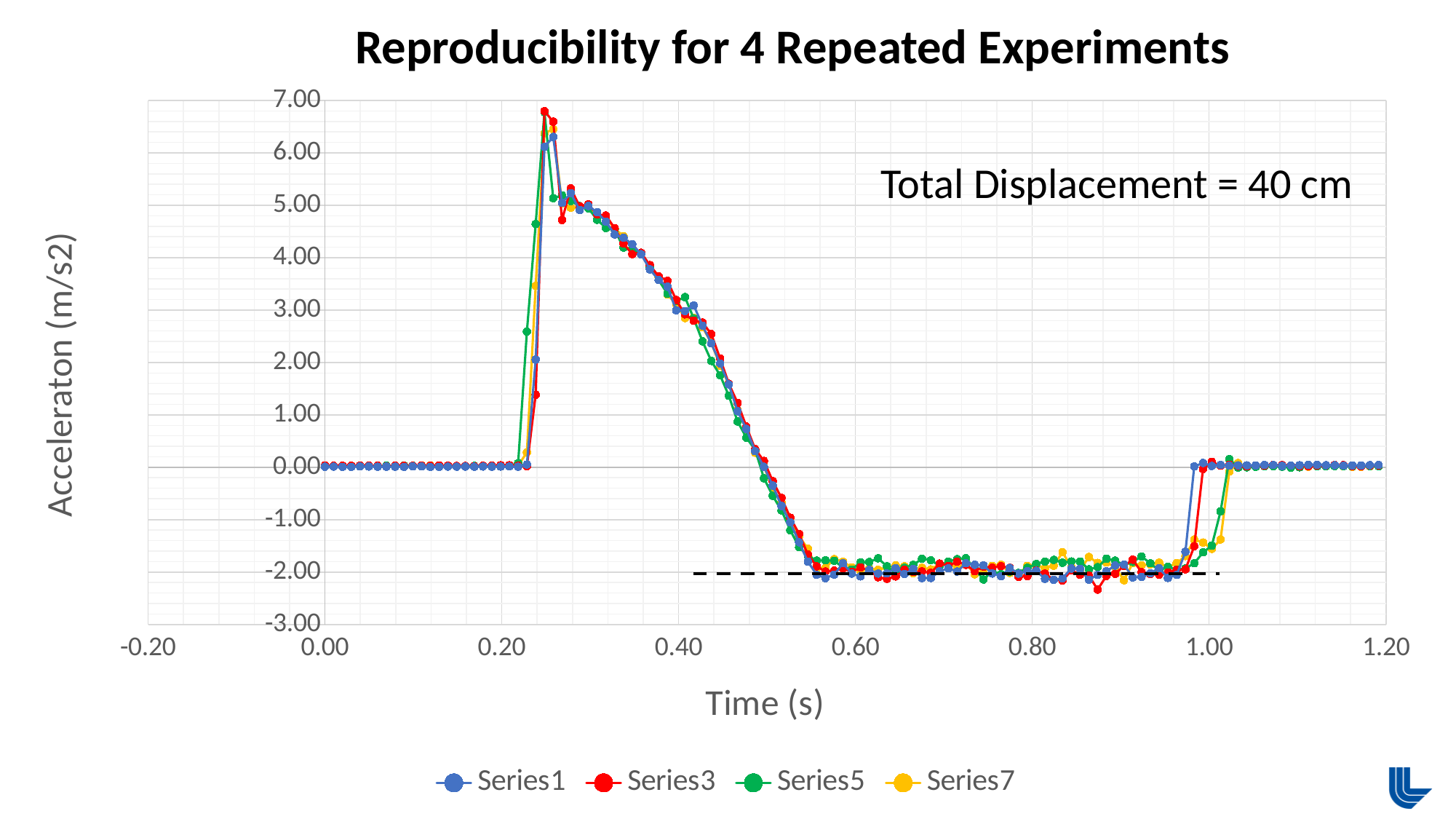
What is the label of the y axis? Acceleraton (m/s2) Is the value of Series1 at about 0.70 s greater or less than -1.00? less How many series does the legend list? 4 What is the title of the chart? Reproducibility for 4 Repeated Experiments What total displacement is stated in the annotation on the chart? 40 cm Is the peak value of Series3 greater or less than 6.00? greater What kind of chart is shown on the slide? line chart Is the value of Series5 at about 0.40 s greater or less than 2.00? greater Do the values of Series1 rise or fall between 0.30 s and 0.55 s? fall